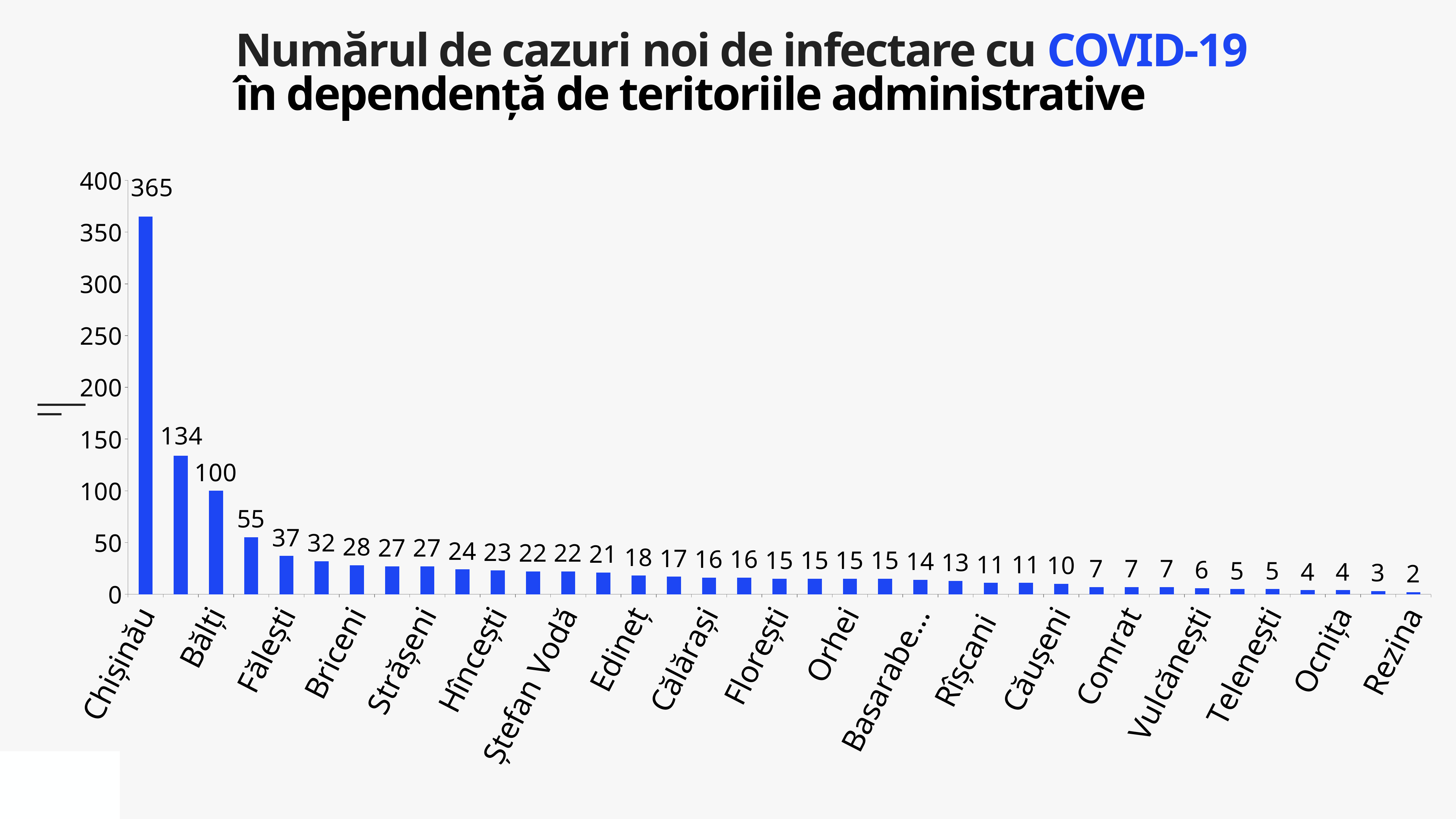
Which territory has the highest number of new cases? Chișinău Which territory has the lowest number of new cases? Rezina What is the value for Bălți? 100 What kind of chart is shown on the slide? bar chart What is the value for Chișinău? 365 What is the value for Rezina? 2 What is the value for Fălești? 37 What is the difference between the values for Chișinău and Rezina? 363 Is the value for Chișinău greater or less than 300? greater Which is larger, the value for Chișinău or the value for Bălți? Chișinău Do the values rise or fall from left to right along the x axis? fall What colour are the bars in the chart? blue